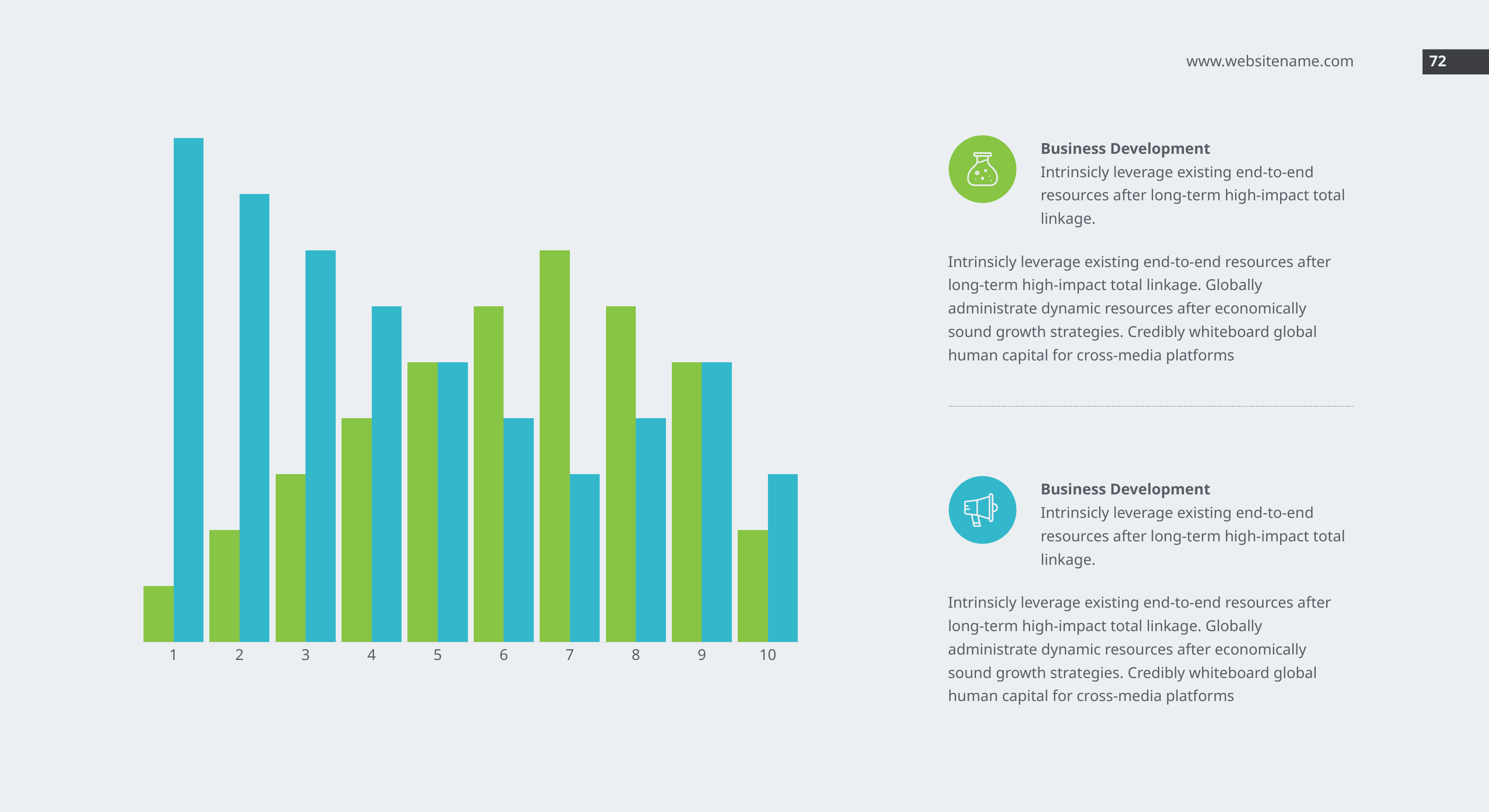
At category 2, which bar is taller, the green bar or the blue bar? blue At category 7, which bar is taller, the green bar or the blue bar? green Do the green bars rise or fall from category 1 to category 5? rise Which category has the tallest green bar? 7 Which category has the tallest blue bar? 1 What two colours are used for the bars in the chart? green and blue At category 1, which bar is taller, the green bar or the blue bar? blue How many bars are plotted for each category in the chart? 2 Do the blue bars rise or fall from category 1 to category 4? fall What kind of chart is shown on the slide? bar chart How many categories are shown on the x axis of the chart? 10 Which category has the shortest green bar? 1